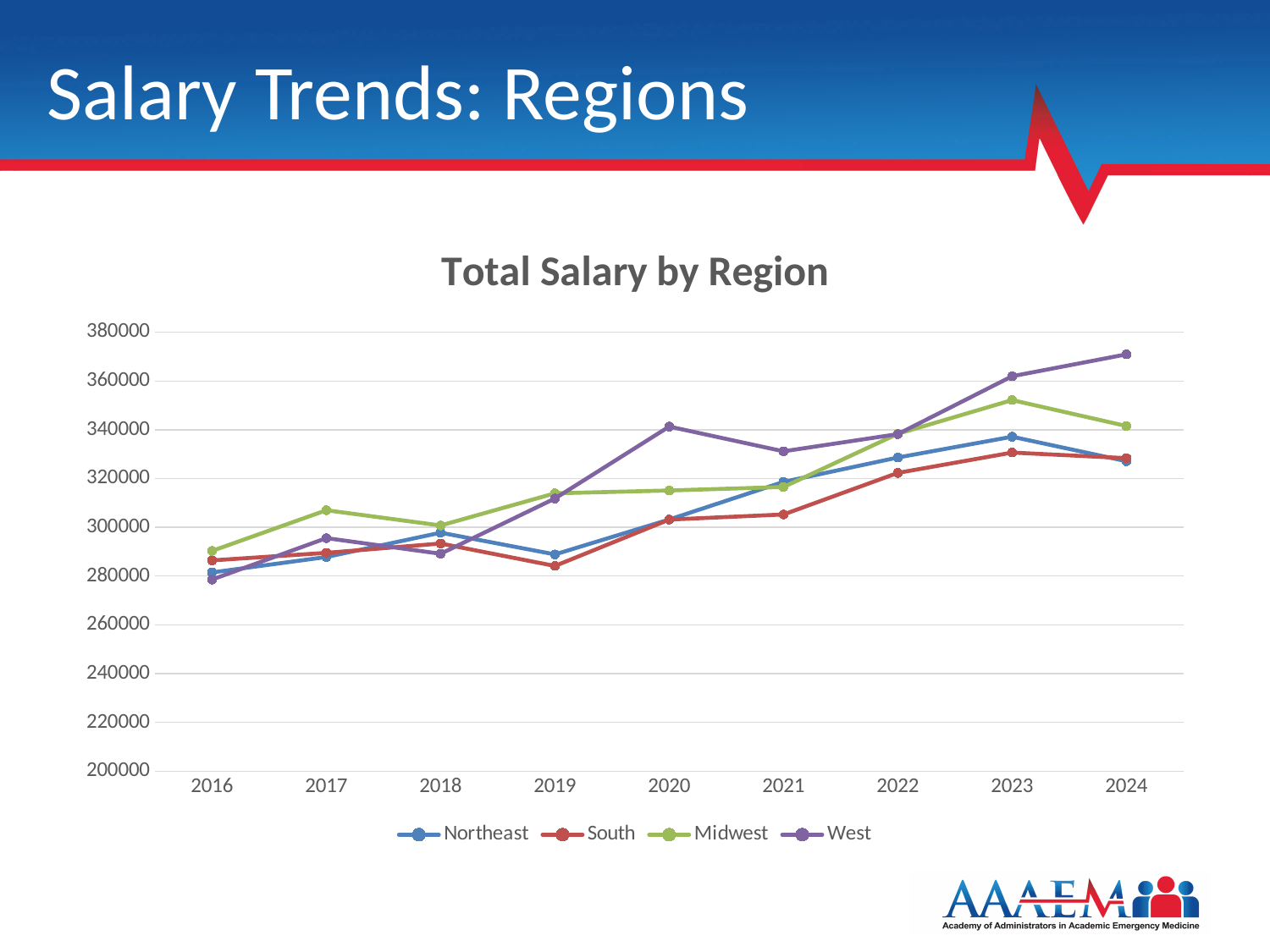
Which region has the highest total salary in 2017? Midwest How many years are shown on the x axis? 9 Which region has the highest total salary in 2020? West Is the value for West in 2024 greater or less than 360000? greater Is the value for Midwest in 2017 greater or less than 300000? greater Which region has the highest total salary in 2024? West How many series does the legend list? 4 In 2023, which is larger, the value for West or the value for Midwest? West Does the West series generally rise or fall from 2016 to 2024? rise Is the value for South in 2019 greater or less than 300000? less What kind of chart is shown on the slide? line chart What is the title of the chart? Total Salary by Region